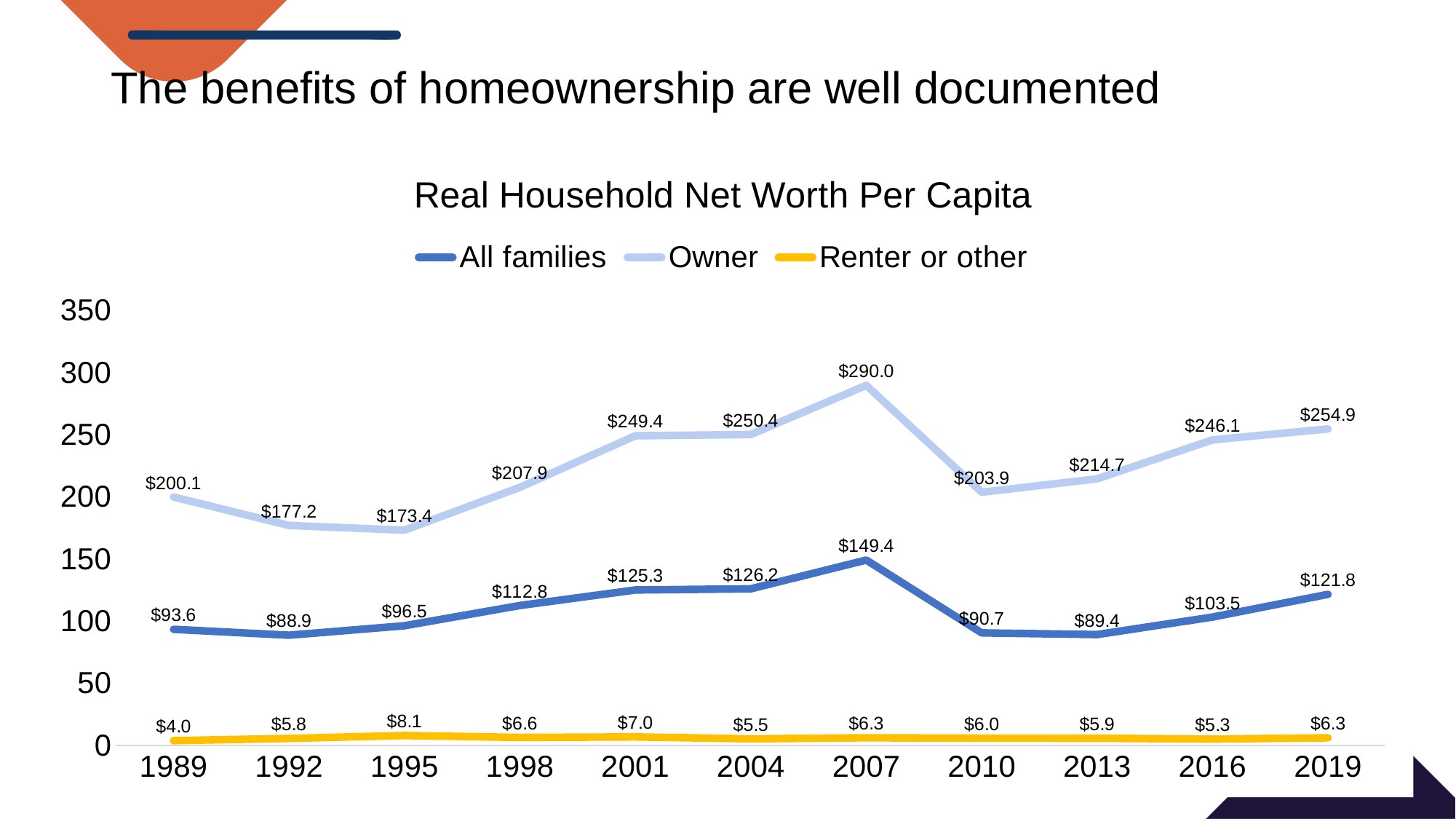
How many series does the legend list? 3 What is the difference between the Owner and All families values in 2019? $133.1 What kind of chart is shown? line chart In which year is the Renter or other series lowest? 1989 Is the Owner value in 2010 greater or less than 250? less Which is larger, the All families value in 2001 or in 2004? 2004 What is the title of the chart? Real Household Net Worth Per Capita What is the value for Owner in 2007? $290.0 How many years are shown on the x axis? 11 What is the value for Renter or other in 1995? $8.1 In which year is the Owner series highest? 2007 What is the value for All families in 1989? $93.6